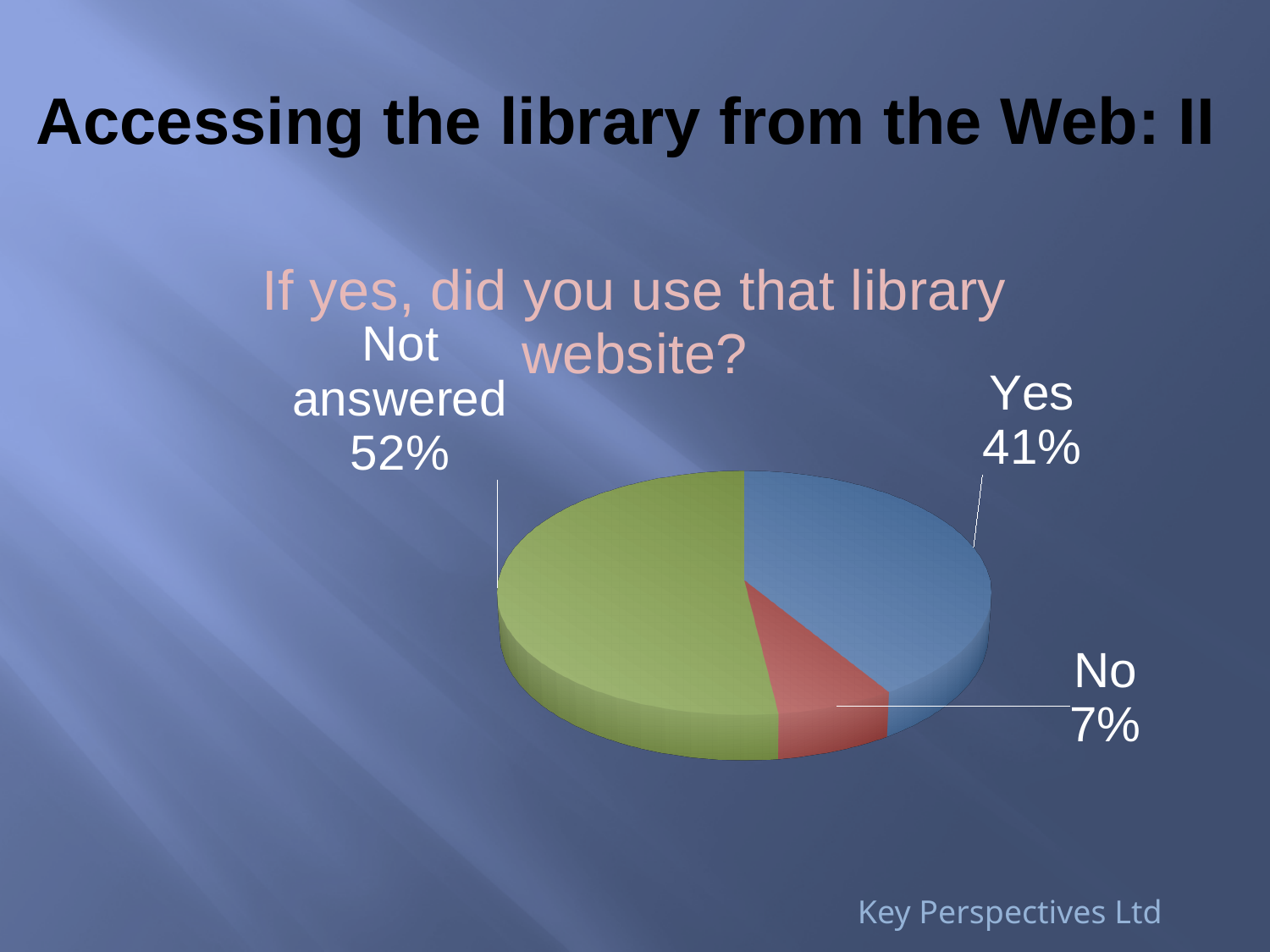
Which category has the largest share of the pie? Not answered What kind of chart is shown on the slide? Pie chart What is the difference in percentage points between Yes and No? 34 What percentage of respondents did not answer? 52% Which is larger, the share for Yes or the share for No? Yes What is the difference in percentage points between Not answered and Yes? 11 Which category has the smallest share of the pie? No How many categories are shown in the pie chart? 3 What is the title of the chart? If yes, did you use that library website? What colour is the slice for Not answered? Green What percentage of respondents answered No? 7% What percentage of respondents answered Yes? 41%